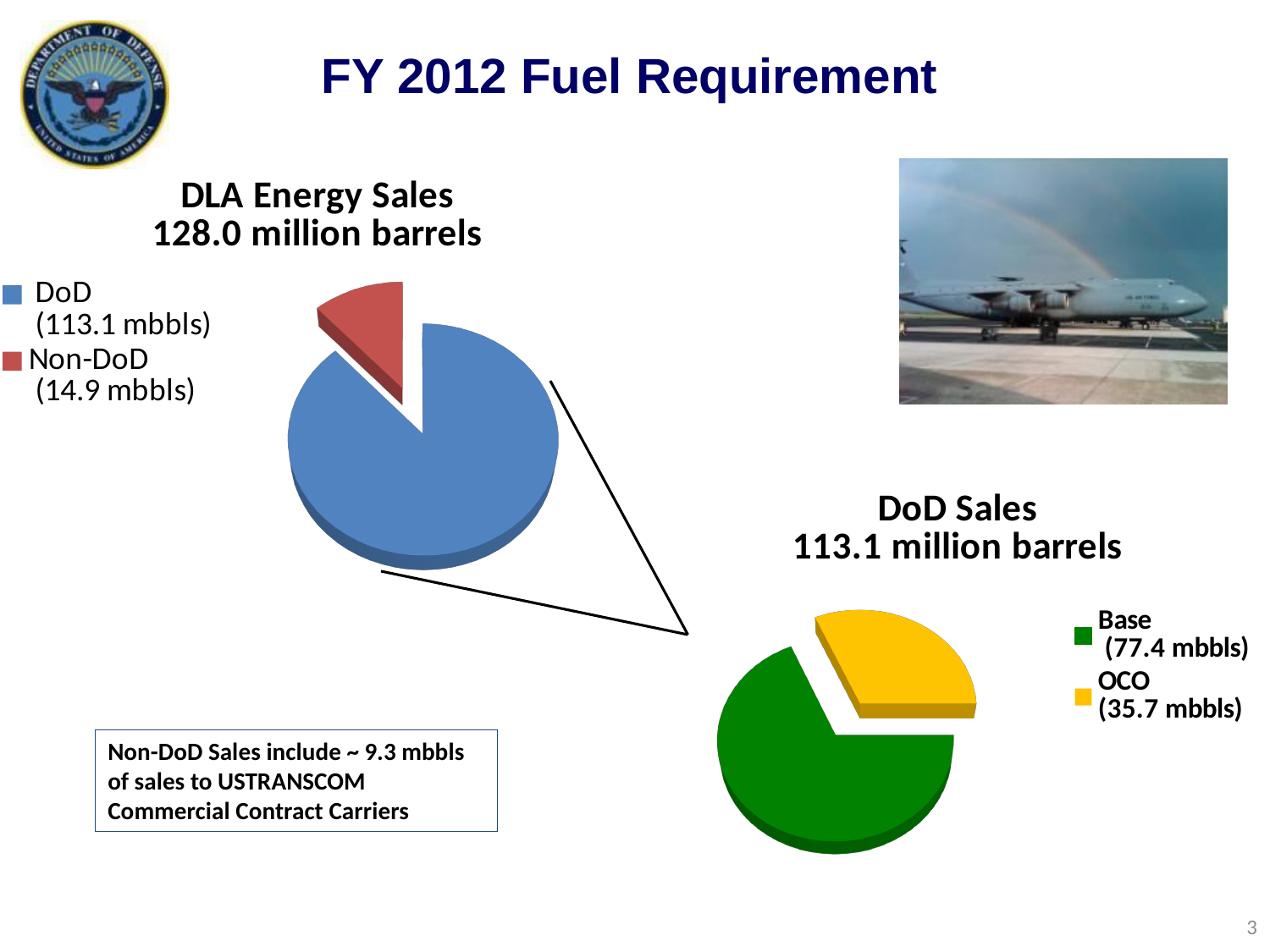
In the DoD Sales chart, what is the difference between Base and OCO? 41.7 mbbls In the DoD Sales chart, which is larger, Base or OCO? Base In the DLA Energy Sales chart, what is the difference between DoD and Non-DoD sales? 98.2 mbbls What total is given in the title of the DLA Energy Sales chart? 128.0 million barrels What kind of chart is the DLA Energy Sales chart? Pie chart In the DLA Energy Sales chart, what is the value for DoD? 113.1 mbbls In the DLA Energy Sales chart, what is the value for Non-DoD? 14.9 mbbls In the DLA Energy Sales chart, which category is the largest? DoD In the DoD Sales chart, what is the value for Base? 77.4 mbbls In the DoD Sales chart, what is the value for OCO? 35.7 mbbls In the DoD Sales chart, which category is the smallest? OCO How many categories does the DoD Sales chart show? 2